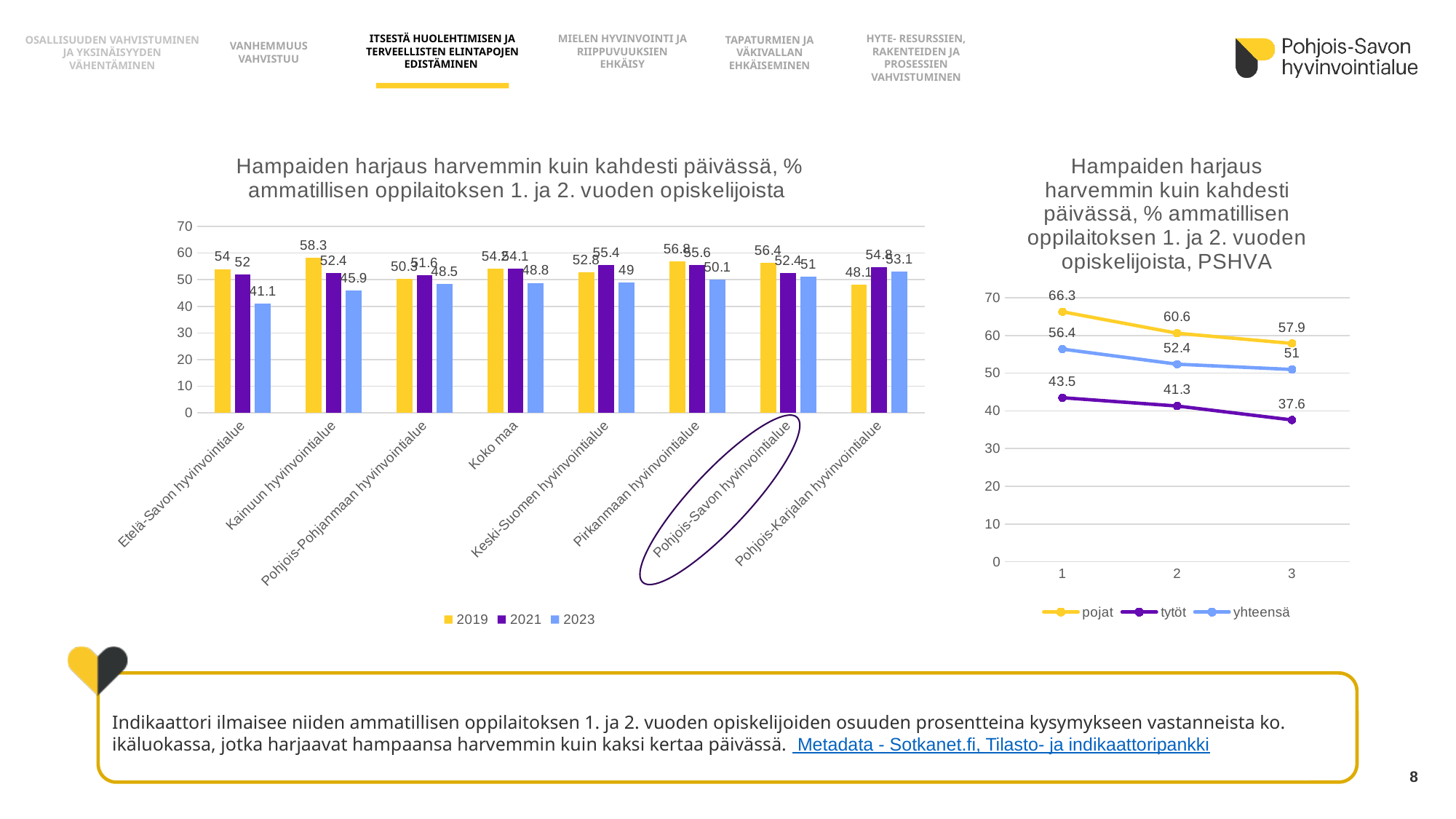
In the left bar chart, which category has the lowest 2023 value? Etelä-Savon hyvinvointialue In the left bar chart, what is the 2023 value for Etelä-Savon hyvinvointialue? 41.1 In the right line chart, what is the value for pojat at point 2? 60.6 In the left bar chart, what is the 2019 value for Kainuun hyvinvointialue? 58.3 In the right line chart, does the tytöt series rise or fall from point 1 to point 3? fall In the left bar chart, what is the difference between the 2019 and 2023 values for Pohjois-Savon hyvinvointialue? 5.4 In the left bar chart, is the 2021 value for Pohjois-Karjalan hyvinvointialue larger or smaller than its 2019 value? larger How many series does the legend of the left bar chart list? 3 How many categories are shown on the x axis of the left bar chart? 8 In the left bar chart, which category has the highest 2019 value? Kainuun hyvinvointialue In the right line chart, what is the difference between pojat and tytöt at point 3? 20.3 What kind of chart is the chart on the right of the slide? line chart